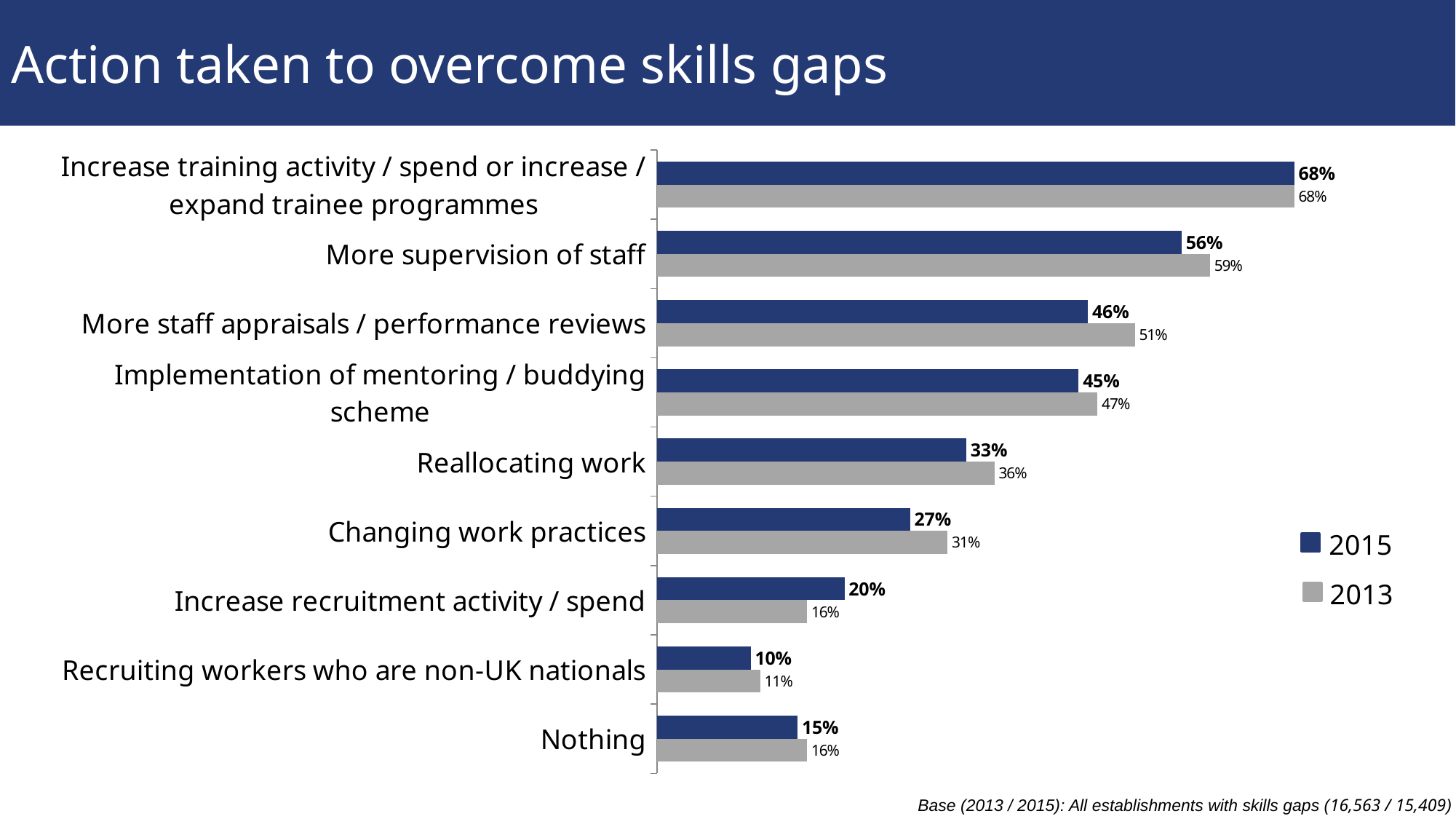
Which category has the highest 2015 value? Increase training activity / spend or increase / expand trainee programmes Which is larger for 'Increase recruitment activity / spend': the 2015 value or the 2013 value? 2015 What is the difference between the 2013 and 2015 values for 'More staff appraisals / performance reviews'? 5% What is the 2015 value for 'More supervision of staff'? 56% How many series does the legend list? 2 Which series is shown in dark blue? 2015 What is the 2015 value for 'Recruiting workers who are non-UK nationals'? 10% Which category has the lowest 2015 value? Recruiting workers who are non-UK nationals How many categories are shown on the chart? 9 Which is larger for 'Changing work practices': the 2015 value or the 2013 value? 2013 What kind of chart is shown on the slide? Bar chart What is the 2013 value for 'Reallocating work'? 36%